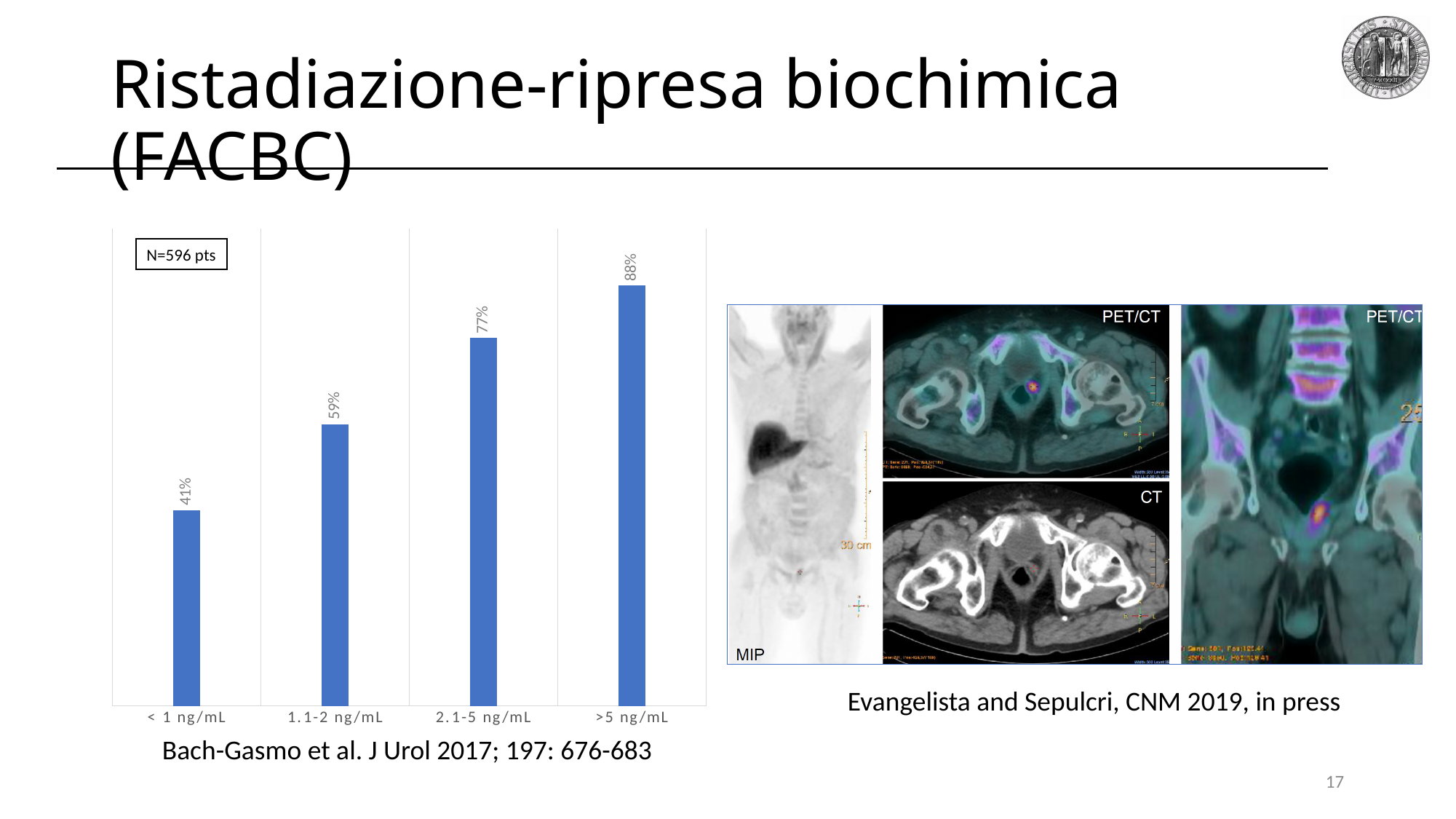
Which category has the lowest value? < 1 ng/mL Which is larger, the value for 1.1-2 ng/mL or the value for 2.1-5 ng/mL? 2.1-5 ng/mL What is the value for the < 1 ng/mL category? 41% Which category has the highest value? >5 ng/mL What kind of chart is shown on the slide? Bar chart Do the values rise or fall from left to right along the x axis? Rise What is the difference between the values for 2.1-5 ng/mL and 1.1-2 ng/mL? 18% What is the value for the 1.1-2 ng/mL category? 59% How many categories are shown on the x axis of the chart? 4 What is the difference between the values for >5 ng/mL and < 1 ng/mL? 47% What is the value for the >5 ng/mL category? 88% What is the value for the 2.1-5 ng/mL category? 77%